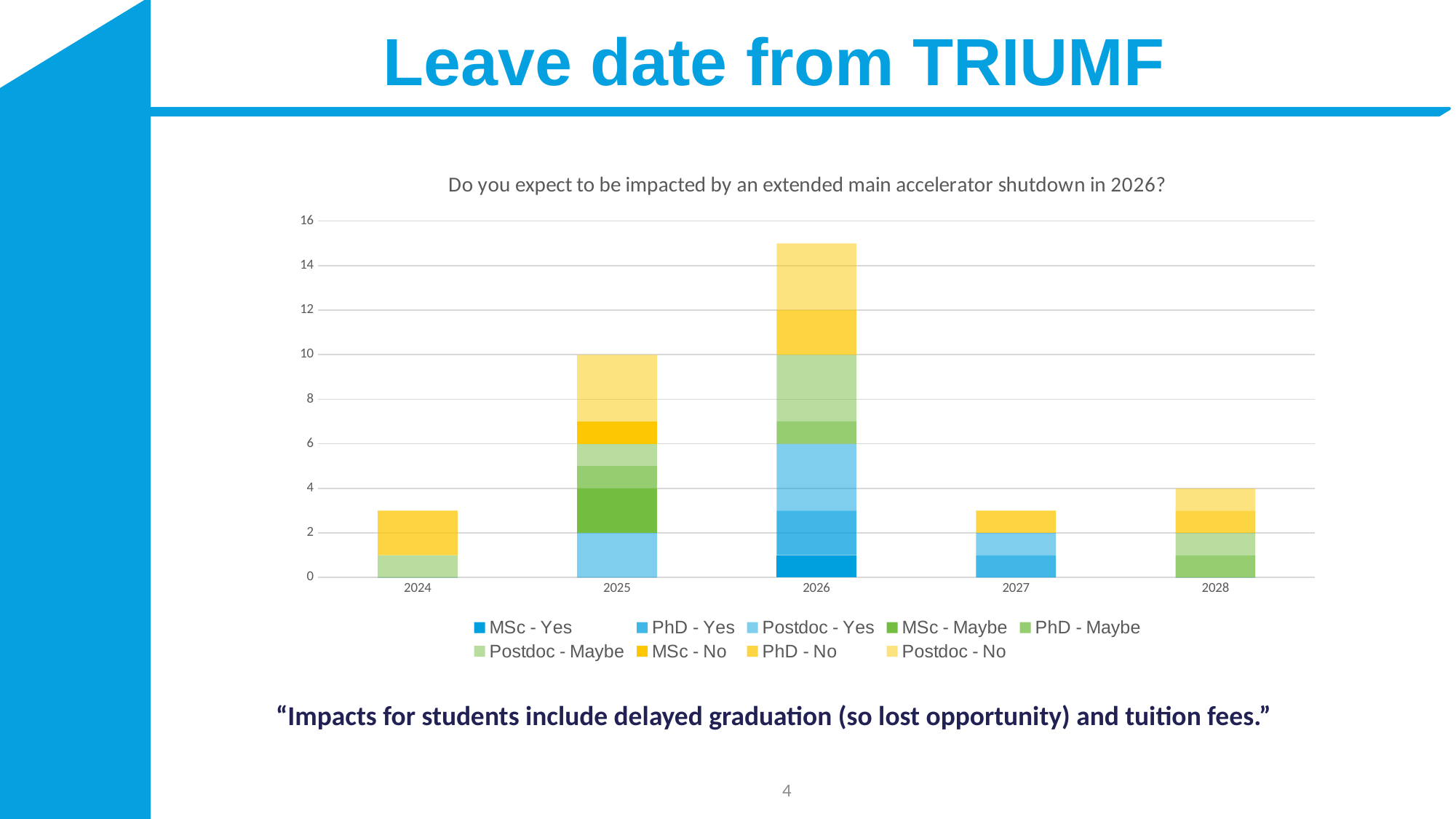
What is the title of the chart? Do you expect to be impacted by an extended main accelerator shutdown in 2026? What is the total height of the stacked bar for 2028? 4 How many series does the legend list? 9 Is the total for 2027 greater or less than 4? less Is the total for 2026 greater or less than 14? greater What kind of chart is shown on the slide? stacked bar chart Is the total for 2024 greater or less than 4? less Does the total rise or fall from 2026 to 2027? fall Which year has the tallest stacked bar? 2026 What is the total height of the stacked bar for 2025? 10 How many years are shown on the x axis of the chart? 5 Which has a larger total, 2025 or 2028? 2025